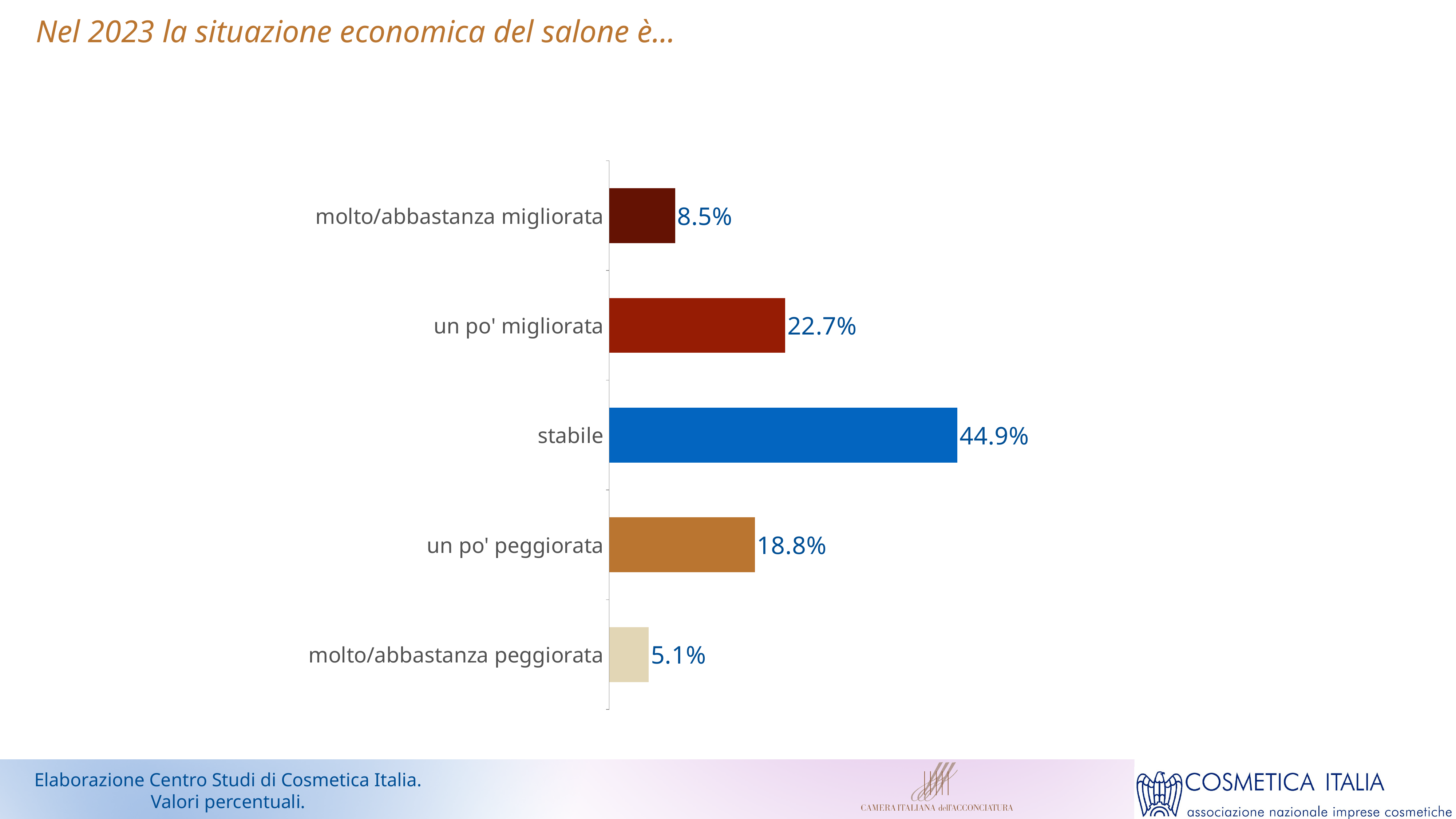
What is the value for "un po' peggiorata"? 18.8% What kind of chart is shown on the slide? bar chart What is the difference between the values for "un po' migliorata" and "un po' peggiorata"? 3.9% How many categories are shown in the chart? 5 Which category has the highest value? stabile What is the value for "stabile"? 44.9% Which is larger, the value for "molto/abbastanza migliorata" or the value for "molto/abbastanza peggiorata"? molto/abbastanza migliorata Which category has the lowest value? molto/abbastanza peggiorata What is the value for "un po' migliorata"? 22.7% What is the value for "molto/abbastanza peggiorata"? 5.1% What is the difference between the values for "stabile" and "un po' migliorata"? 22.2% What is the title of the slide? Nel 2023 la situazione economica del salone è…